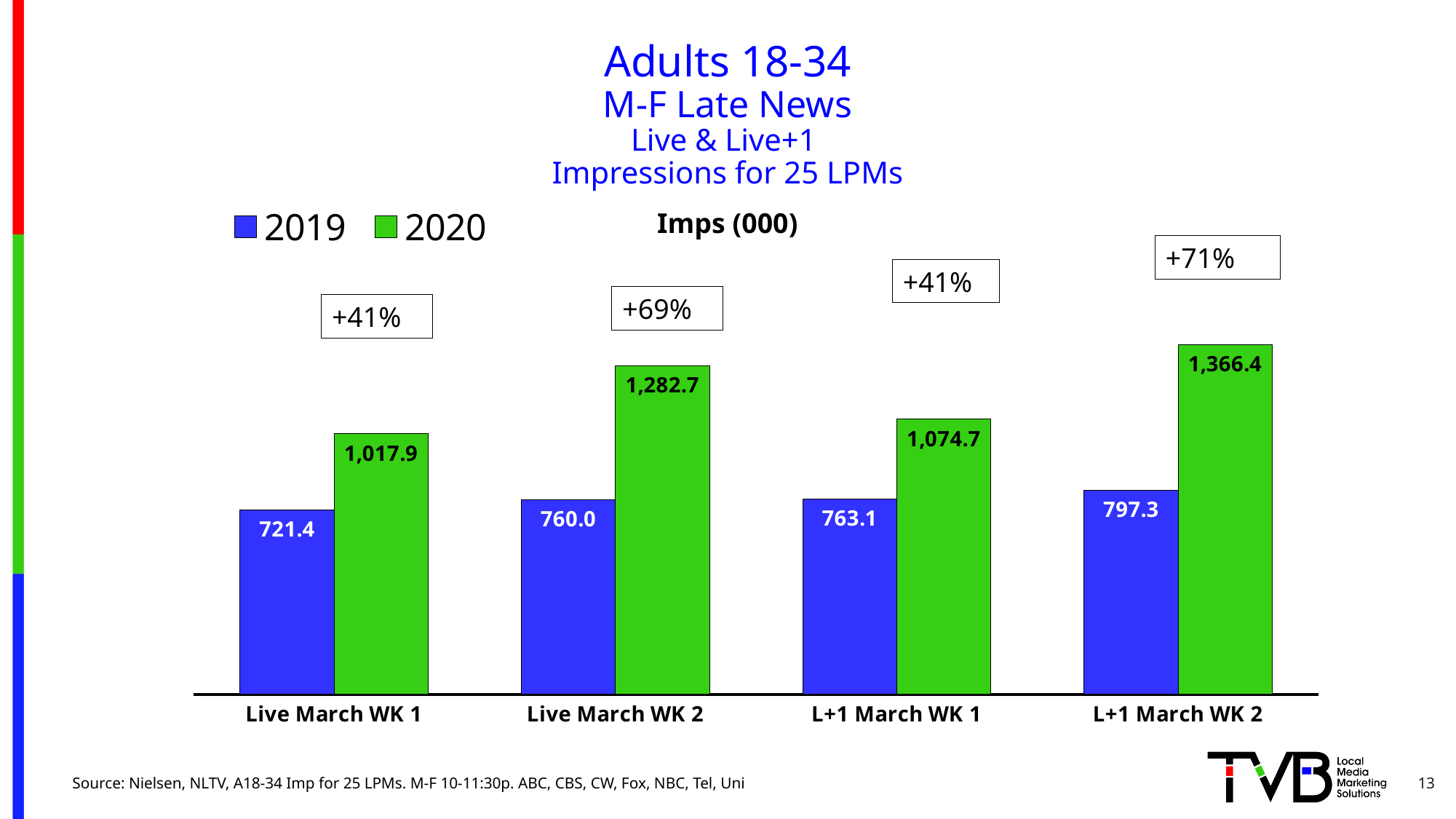
What is the 2019 value for L+1 March WK 1? 763.1 Which is larger, the 2019 value for Live March WK 2 or the 2019 value for L+1 March WK 2? L+1 March WK 2 What is the difference between the 2020 and 2019 values for Live March WK 1? 296.5 How many series does the legend list? 2 How many categories are shown on the x axis? 4 Which category has the lowest 2019 value? Live March WK 1 What is the 2019 value for Live March WK 1? 721.4 What kind of chart is shown on the slide? bar chart Which category has the highest 2020 value? L+1 March WK 2 What percentage change is shown above the L+1 March WK 2 bars? +71% What is the 2020 value for Live March WK 2? 1,282.7 What is the 2020 value for L+1 March WK 2? 1,366.4